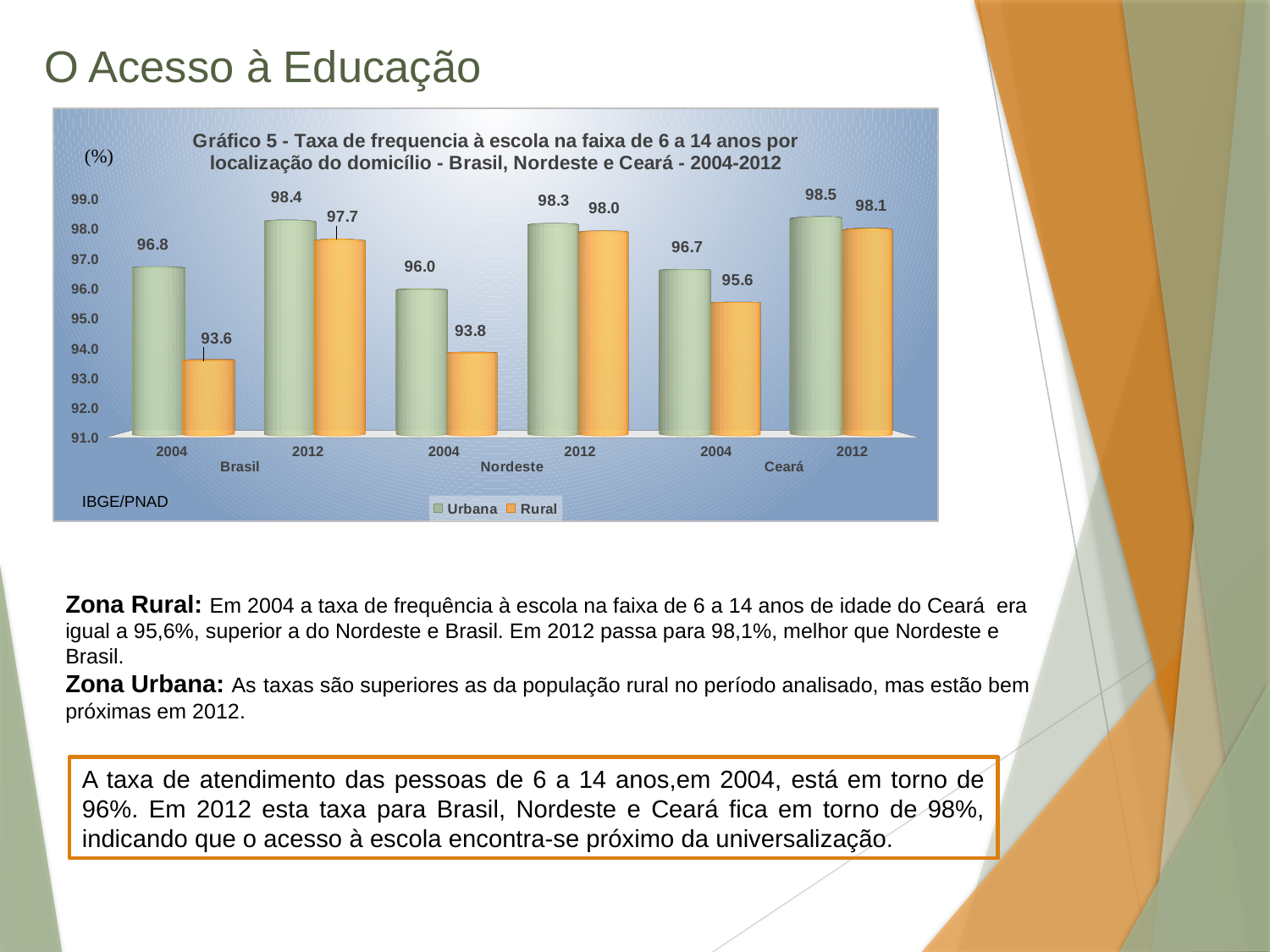
Which is larger, the Rural value for Ceará in 2004 or the Rural value for Nordeste in 2004? Ceará 2004 What is the Urbana value for Nordeste in 2012? 98.3 What is the difference between the Urbana and Rural values for Brasil in 2004? 3.2 Which category has the highest Urbana value? Ceará 2012 Does the Rural value for Brasil rise or fall from 2004 to 2012? Rise What kind of chart is shown on the slide? Bar chart What is the data source shown at the bottom left of the chart? IBGE/PNAD What is the Rural value for Ceará in 2012? 98.1 How many series does the legend list? 2 Which category has the lowest Rural value? Brasil 2004 What is the Rural value for Nordeste in 2004? 93.8 What is the Urbana value for Brasil in 2004? 96.8